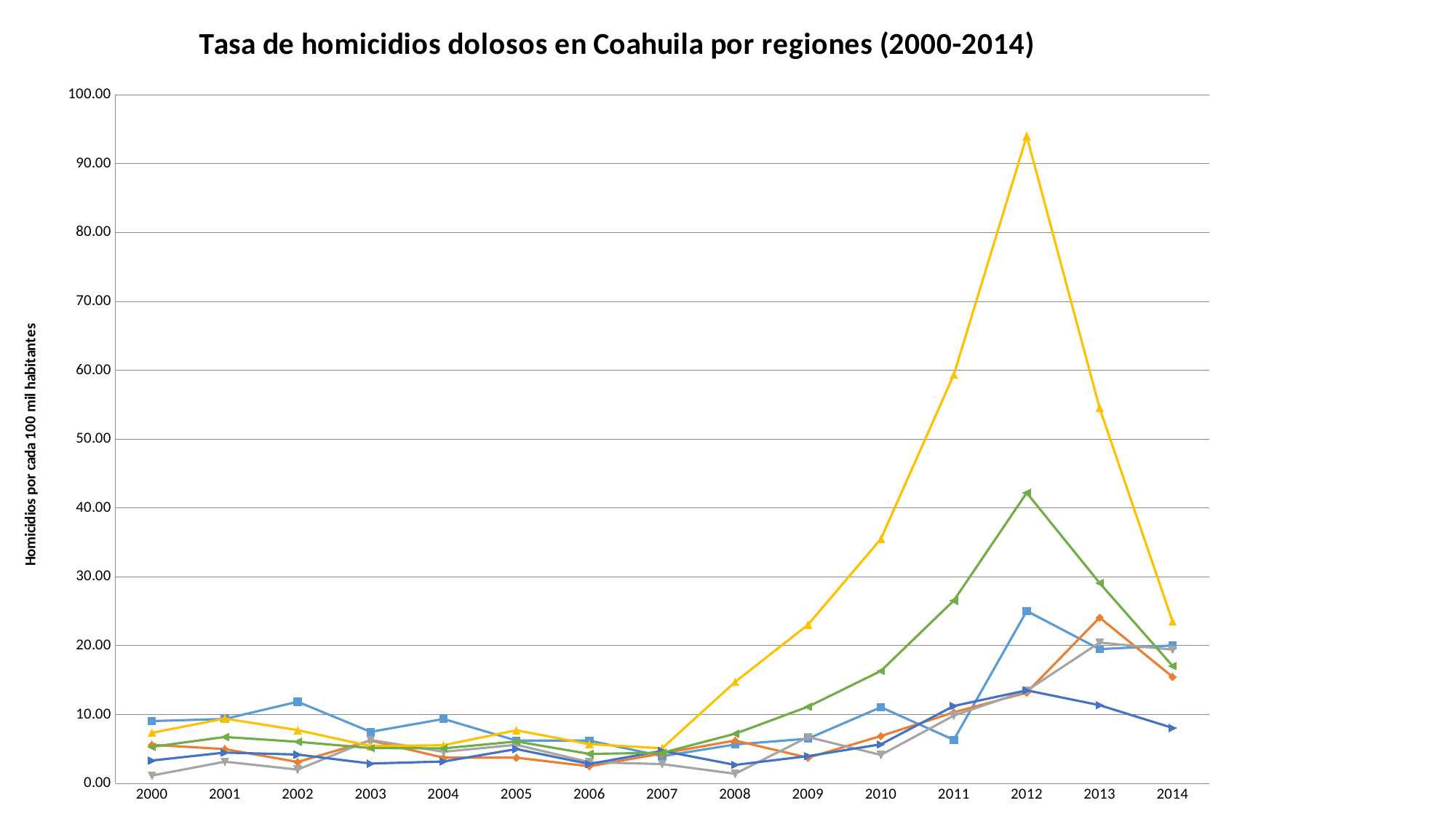
Does the yellow line rise or fall between 2012 and 2014? fall How many years are shown along the x axis? 15 Is the value of the yellow line in 2012 greater or less than 90? greater What is the title of the chart? Tasa de homicidios dolosos en Coahuila por regiones (2000-2014) How many lines (series) are plotted on the chart? 6 Is the value of the green line in 2012 greater or less than 40? greater Is the value of the yellow line in 2010 greater or less than 30? greater In which year does the yellow line reach its highest value? 2012 What is the label of the vertical axis? Homicidios por cada 100 mil habitantes Which line has the higher value in 2012, the yellow line or the green line? yellow line What kind of chart is shown on the slide? line chart